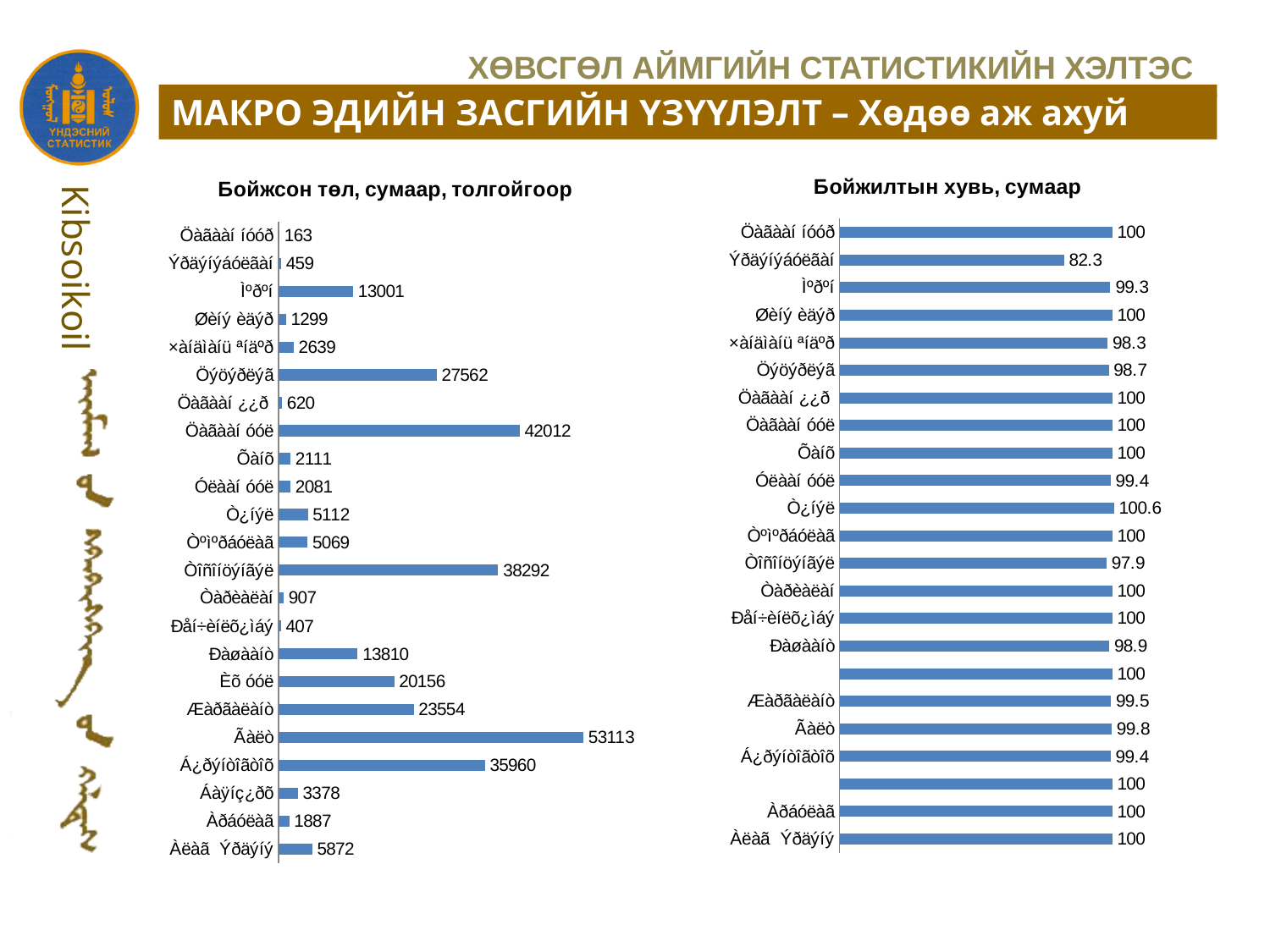
What kind of chart is the left chart titled 'Бойжсон төл, сумаар, толгойгоор'? bar chart How many bars are plotted in the right chart 'Бойжилтын хувь, сумаар'? 23 In the left chart 'Бойжсон төл, сумаар, толгойгоор', what is the smallest value shown? 163 What is the title of the chart on the right side of the slide? Бойжилтын хувь, сумаар In the left chart 'Бойжсон төл, сумаар, толгойгоор', which is larger: the top bar or the bottom bar? the bottom bar In the left chart 'Бойжсон төл, сумаар, толгойгоор', what is the largest value shown? 53113 In the right chart 'Бойжилтын хувь, сумаар', what is the value of the second bar from the top? 82.3 In the right chart 'Бойжилтын хувь, сумаар', what is the highest value shown? 100.6 In the right chart 'Бойжилтын хувь, сумаар', what is the lowest value shown? 82.3 In the left chart 'Бойжсон төл, сумаар, толгойгоор', what is the difference between the largest value (53113) and the smallest value (163)? 52950 How many bars are plotted in the left chart 'Бойжсон төл, сумаар, толгойгоор'? 23 In the left chart 'Бойжсон төл, сумаар, толгойгоор', what is the value of the bottom bar? 5872